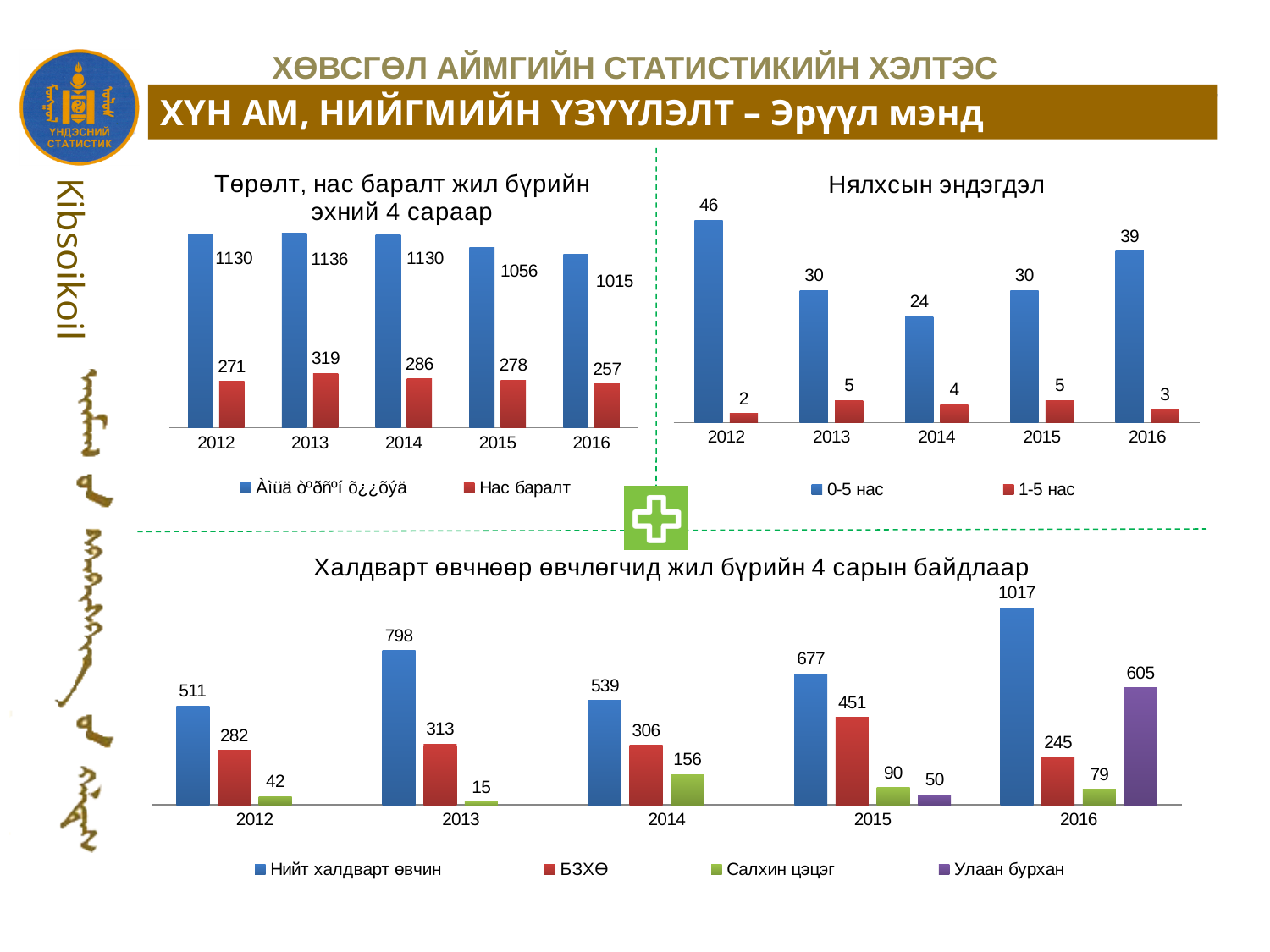
In the chart titled "Төрөлт, нас баралт жил бүрийн эхний 4 сараар", which year has the lowest value for "Нас баралт"? 2016 In the chart titled "Нялхсын эндэгдэл", which year has the lowest value for "0-5 нас"? 2014 In the chart titled "Нялхсын эндэгдэл", what is the value for "0-5 нас" in 2012? 46 In the chart titled "Халдварт өвчнөөр өвчлөгчид жил бүрийн 4 сарын байдлаар", what is the value for "Улаан бурхан" in 2016? 605 In the chart titled "Халдварт өвчнөөр өвчлөгчид жил бүрийн 4 сарын байдлаар", how many series does the legend list? 4 In the chart titled "Халдварт өвчнөөр өвчлөгчид жил бүрийн 4 сарын байдлаар", which is larger in 2014: "БЗХӨ" or "Салхин цэцэг"? БЗХӨ In the chart titled "Төрөлт, нас баралт жил бүрийн эхний 4 сараар", what is the value for "Нас баралт" in 2013? 319 In the chart titled "Халдварт өвчнөөр өвчлөгчид жил бүрийн 4 сарын байдлаар", which year has the highest value for "БЗХӨ"? 2015 In the chart titled "Халдварт өвчнөөр өвчлөгчид жил бүрийн 4 сарын байдлаар", what is the value for "Нийт халдварт өвчин" in 2016? 1017 In the chart titled "Нялхсын эндэгдэл", what is the difference between the "0-5 нас" value and the "1-5 нас" value in 2016? 36 In the chart titled "Төрөлт, нас баралт жил бүрийн эхний 4 сараар", what is the value of the blue bar in 2015? 1056 In the chart titled "Төрөлт, нас баралт жил бүрийн эхний 4 сараар", do the blue bars rise or fall from 2014 to 2016? fall